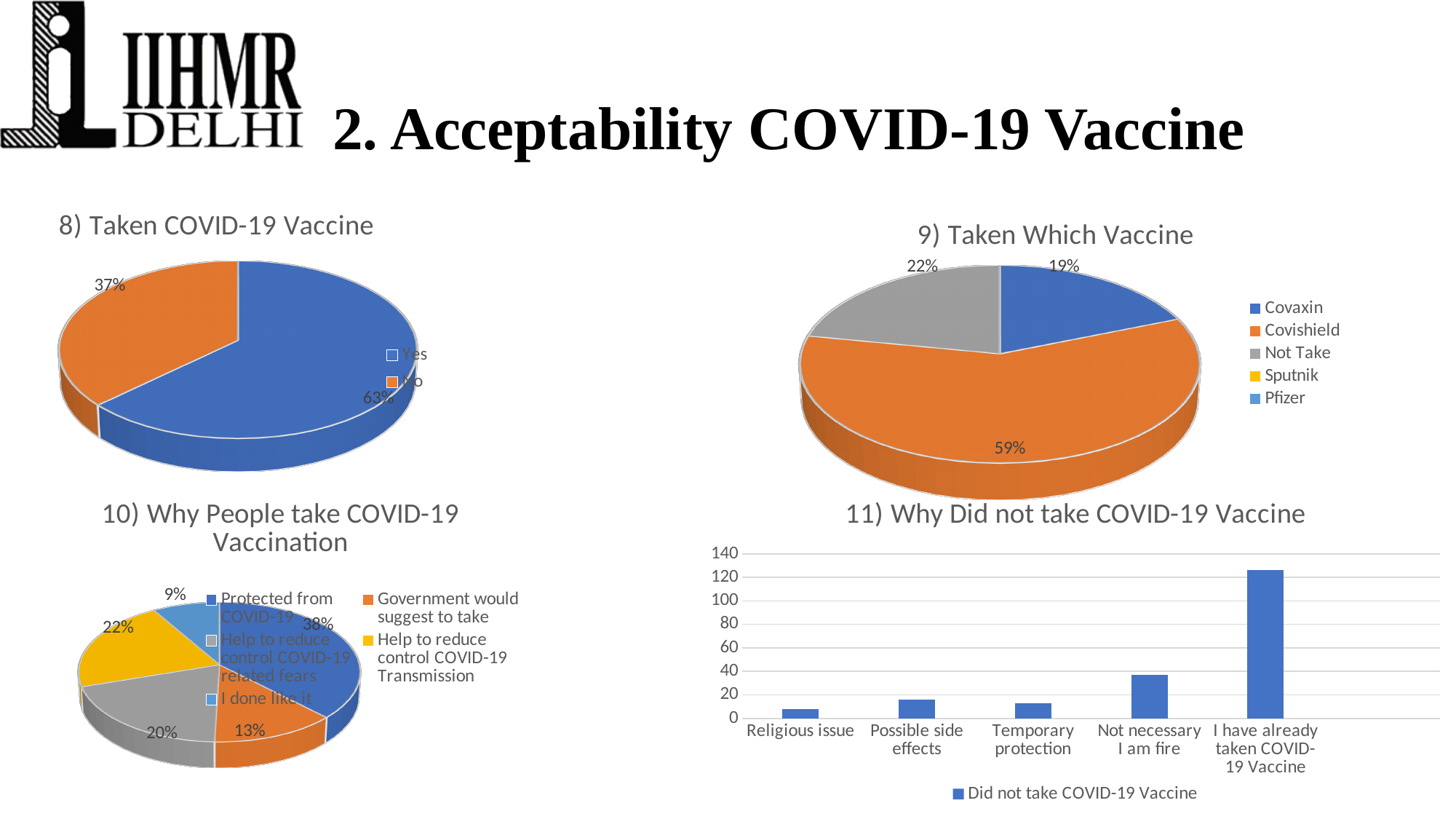
What kind of chart is '11) Why Did not take COVID-19 Vaccine'? Bar chart In the chart '11) Why Did not take COVID-19 Vaccine', is the value for 'Not necessary I am fire' greater or less than 20? greater In the chart '9) Taken Which Vaccine', how many entries does the legend list? 5 In the chart '8) Taken COVID-19 Vaccine', what percentage of respondents answered Yes? 63% In the chart '10) Why People take COVID-19 Vaccination', what is the difference between the shares for 'Help to reduce control COVID-19 Transmission' and 'Government would suggest to take'? 9% In the chart '9) Taken Which Vaccine', which vaccine has the largest share? Covishield In the chart '10) Why People take COVID-19 Vaccination', which reason has the smallest share? I done like it In the chart '9) Taken Which Vaccine', what percentage is shown for Covishield? 59% In the chart '9) Taken Which Vaccine', which is larger, the share for Covaxin or the share for Not Take? Not Take In the chart '8) Taken COVID-19 Vaccine', what is the difference between the Yes and No shares? 26% In the chart '10) Why People take COVID-19 Vaccination', what percentage is shown for 'Protected from COVID-19'? 38% In the chart '11) Why Did not take COVID-19 Vaccine', which category has the highest value? I have already taken COVID-19 Vaccine